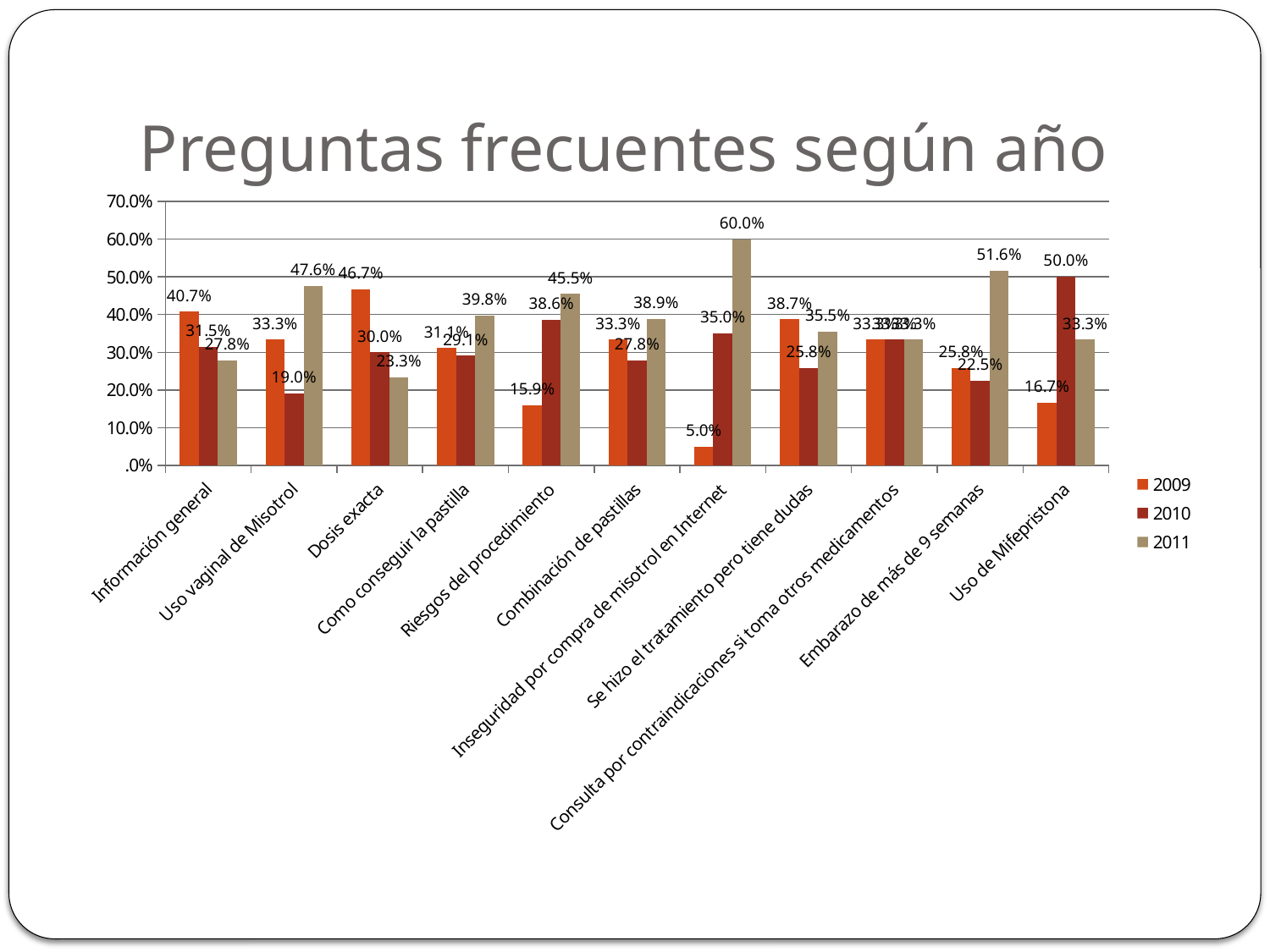
What is the value for 2011 for 'Inseguridad por compra de misotrol en Internet'? 60.0% For 'Riesgos del procedimiento', which is larger: the 2009 value or the 2010 value? 2010 Which category has the highest value for the 2011 series? Inseguridad por compra de misotrol en Internet What is the title of the chart? Preguntas frecuentes según año Is the 2011 value for 'Uso vaginal de Misotrol' greater or less than 40.0%? greater How many series does the legend list? 3 How many categories are shown on the x axis? 11 What is the value for 2010 for 'Uso de Mifepristona'? 50.0% What is the difference between the 2011 and 2009 values for 'Embarazo de más de 9 semanas'? 25.8% Which category has the lowest value for the 2009 series? Inseguridad por compra de misotrol en Internet What type of chart is shown on the slide? bar chart What is the value for 2009 for 'Dosis exacta'? 46.7%